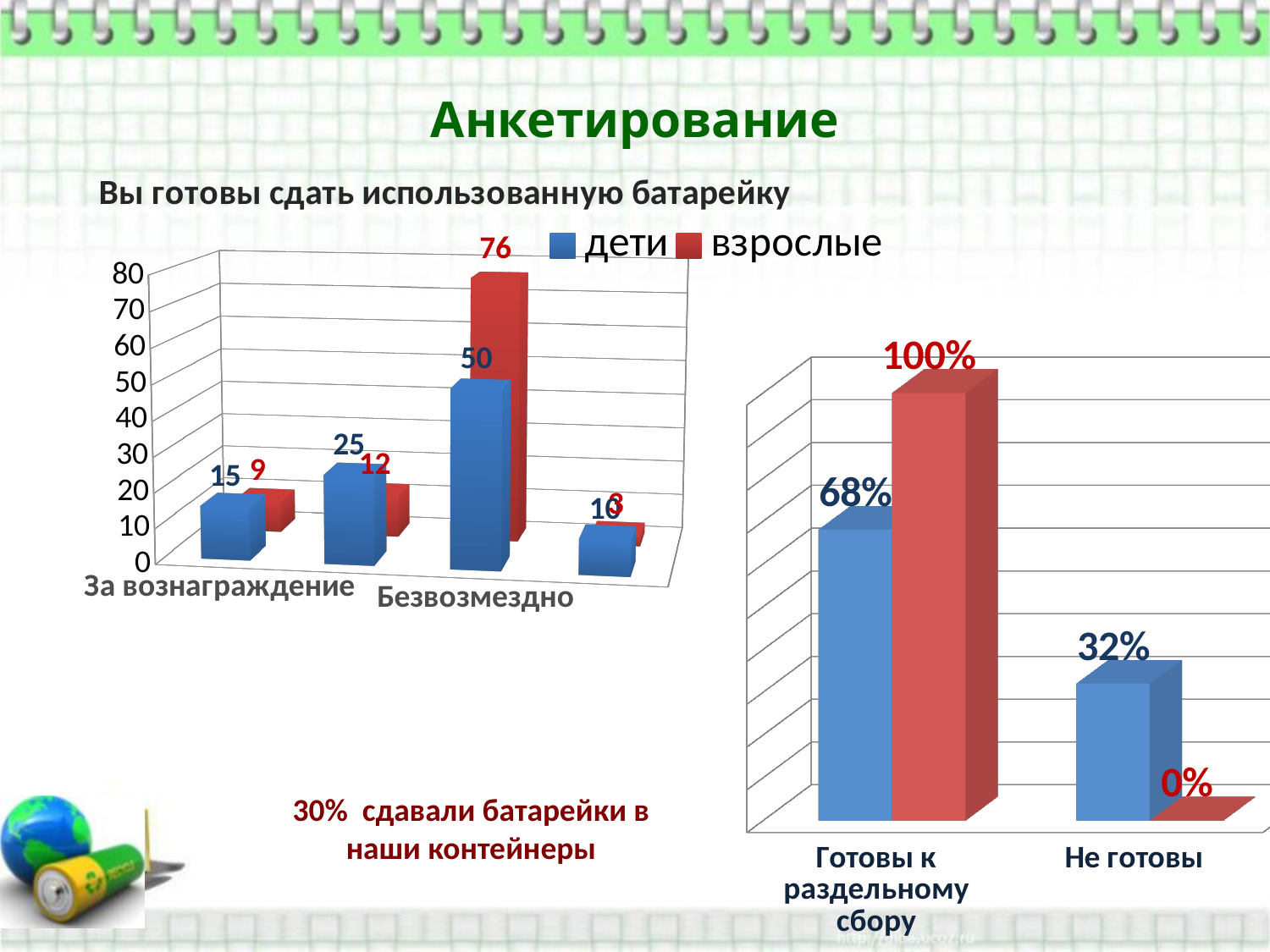
In the right chart, what is the value of the blue bar for 'Готовы к раздельному сбору'? 68% In the right chart, which is larger for 'Готовы к раздельному сбору': the blue bar or the red bar? the red bar (100%) In the left chart, what is the highest value shown for the взрослые series? 76 In the left chart, is the tallest red (взрослые) bar greater or less than 70? greater In the left chart, what is the highest value shown for the дети series? 50 What kind of chart is the chart on the left of the slide? bar chart In the right chart, what is the difference between the blue bar values for 'Готовы к раздельному сбору' (68%) and 'Не готовы' (32%)? 36% In the left chart, how many groups of bars are plotted? 4 In the right chart, what is the value of the red bar for 'Не готовы'? 0% In the left chart, what is the difference between the highest взрослые value (76) and the highest дети value (50)? 26 What are the two series named in the legend of the left chart? дети, взрослые How many series does the legend of the left chart list? 2